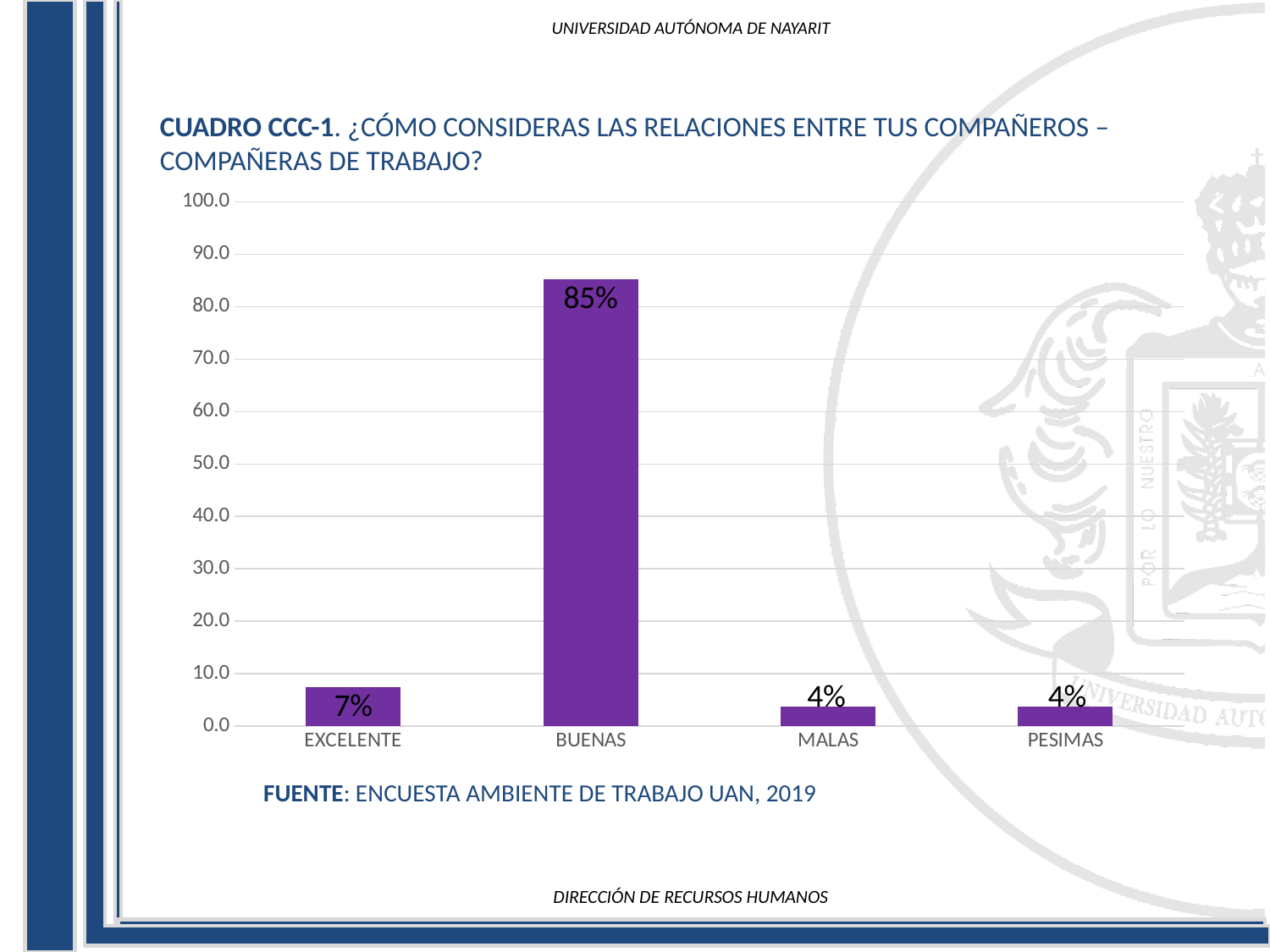
How many categories are shown on the x axis? 4 What is the value for MALAS? 4% Is the value for BUENAS greater or less than 80.0? greater Which is larger, the value for EXCELENTE or the value for PESIMAS? EXCELENTE What is the difference between the values for EXCELENTE and MALAS? 3% What is the value for PESIMAS? 4% What is the difference between the values for BUENAS and EXCELENTE? 78% What kind of chart is shown on the slide? bar chart What source is cited below the chart? ENCUESTA AMBIENTE DE TRABAJO UAN, 2019 What is the value for BUENAS? 85% What is the value for EXCELENTE? 7% Which category has the highest value? BUENAS